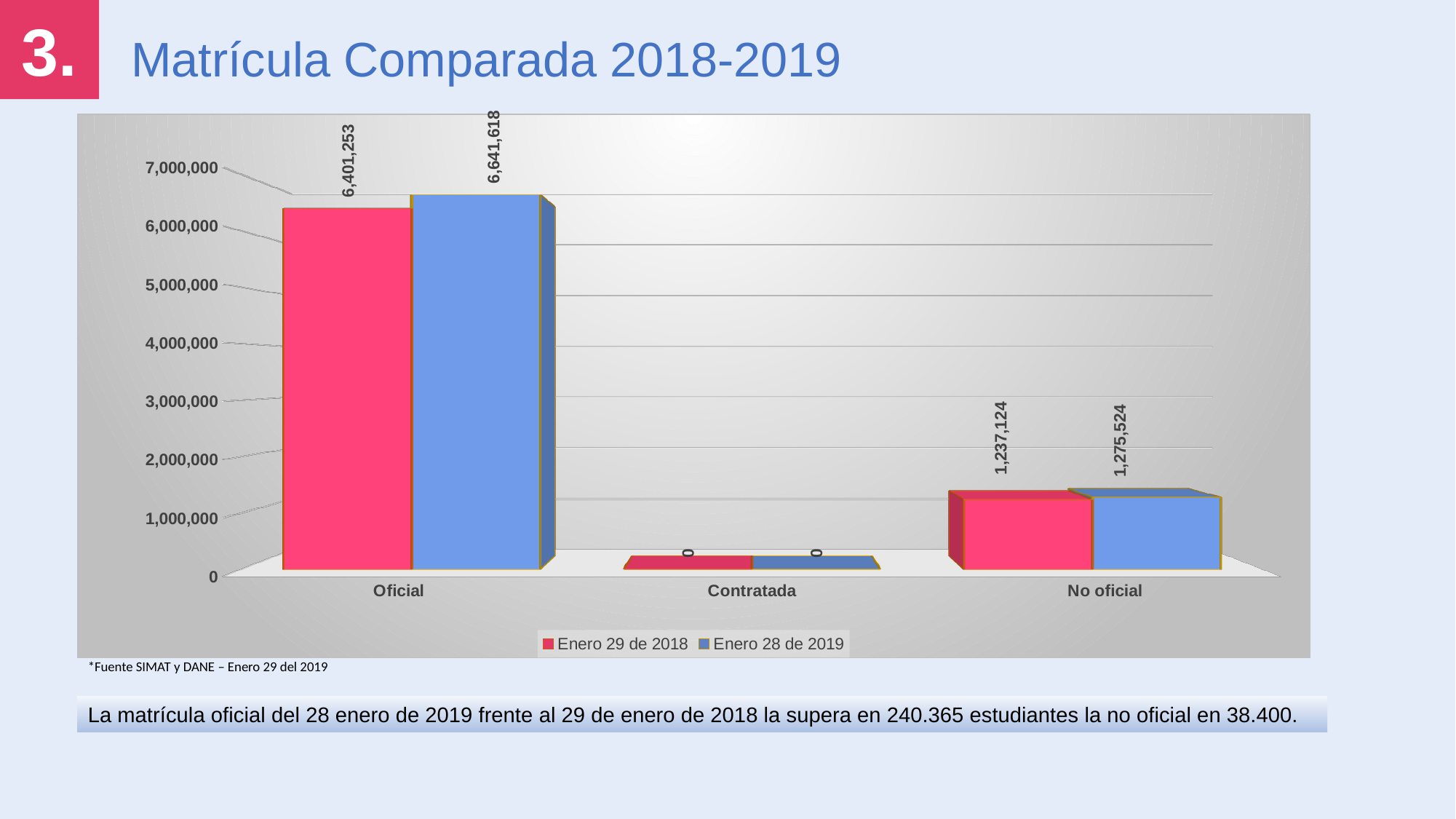
What is the value for Contratada in the Enero 28 de 2019 series? 0 What is the value for No oficial in the Enero 28 de 2019 series? 1,275,524 What is the value for Oficial in the Enero 28 de 2019 series? 6,641,618 Which category has the highest value in the Enero 28 de 2019 series? Oficial Which is larger for No oficial: the Enero 29 de 2018 value or the Enero 28 de 2019 value? Enero 28 de 2019 What is the value for No oficial in the Enero 29 de 2018 series? 1,237,124 Which category has the lowest value in the Enero 29 de 2018 series? Contratada What is the value for Oficial in the Enero 29 de 2018 series? 6,401,253 What is the difference between the Enero 28 de 2019 and Enero 29 de 2018 values for No oficial? 38,400 What is the difference between the Enero 28 de 2019 and Enero 29 de 2018 values for Oficial? 240,365 How many categories are shown on the x axis? 3 How many series does the legend list? 2